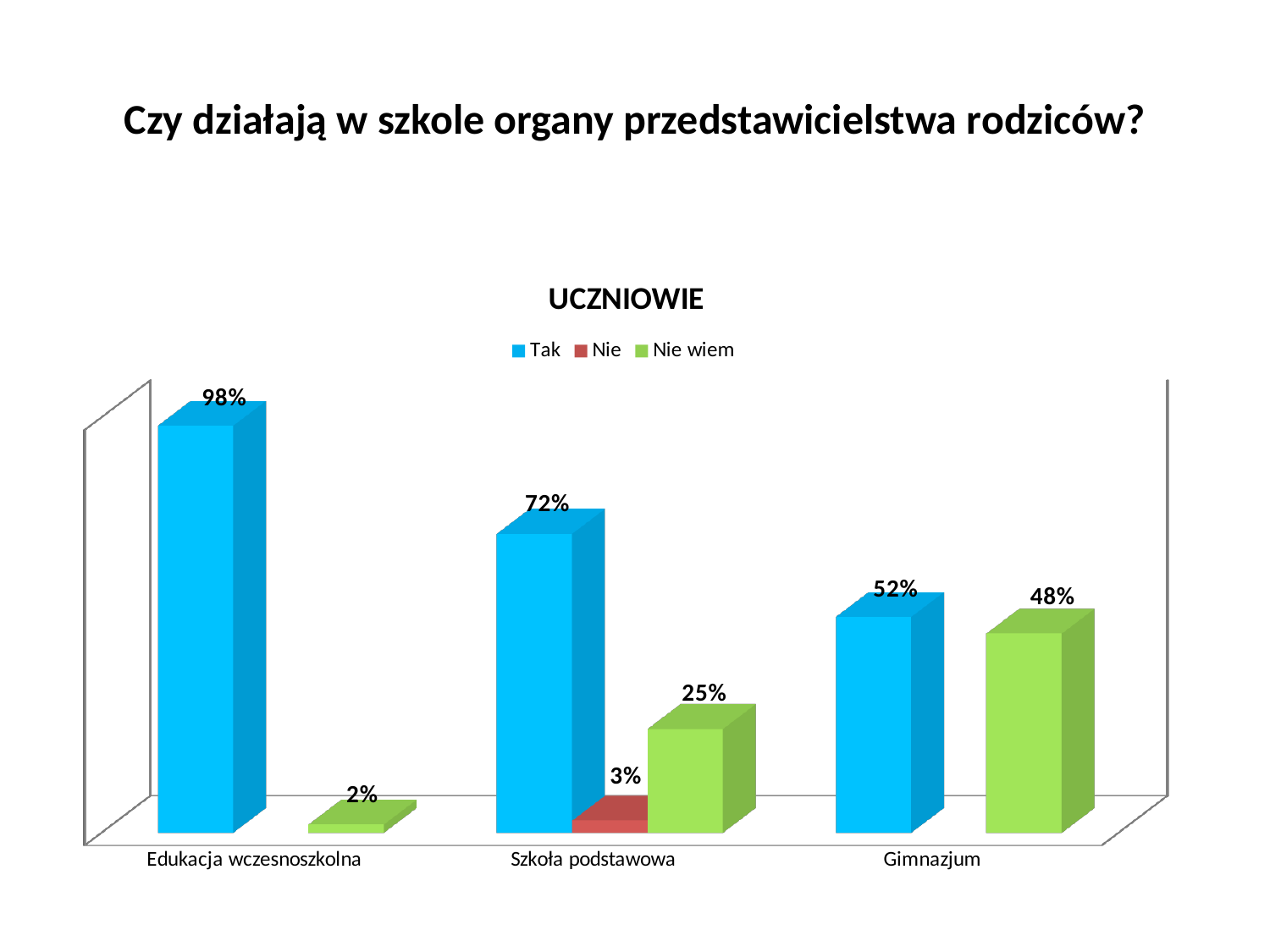
How many categories are shown on the x axis? 3 What is the value for "Nie wiem" in the Szkoła podstawowa category? 25% Which category has the highest value for "Tak"? Edukacja wczesnoszkolna What kind of chart is shown on the slide? Bar chart How many series does the legend list? 3 What is the title of the chart? UCZNIOWIE Which category has the lowest value for "Nie wiem"? Edukacja wczesnoszkolna Which is larger in the Gimnazjum category: "Tak" or "Nie wiem"? Tak What is the difference between the "Tak" values for Edukacja wczesnoszkolna and Gimnazjum? 46% What is the value for "Nie" in the Szkoła podstawowa category? 3% What is the value for "Tak" in the Edukacja wczesnoszkolna category? 98% What is the value for "Nie wiem" in the Gimnazjum category? 48%